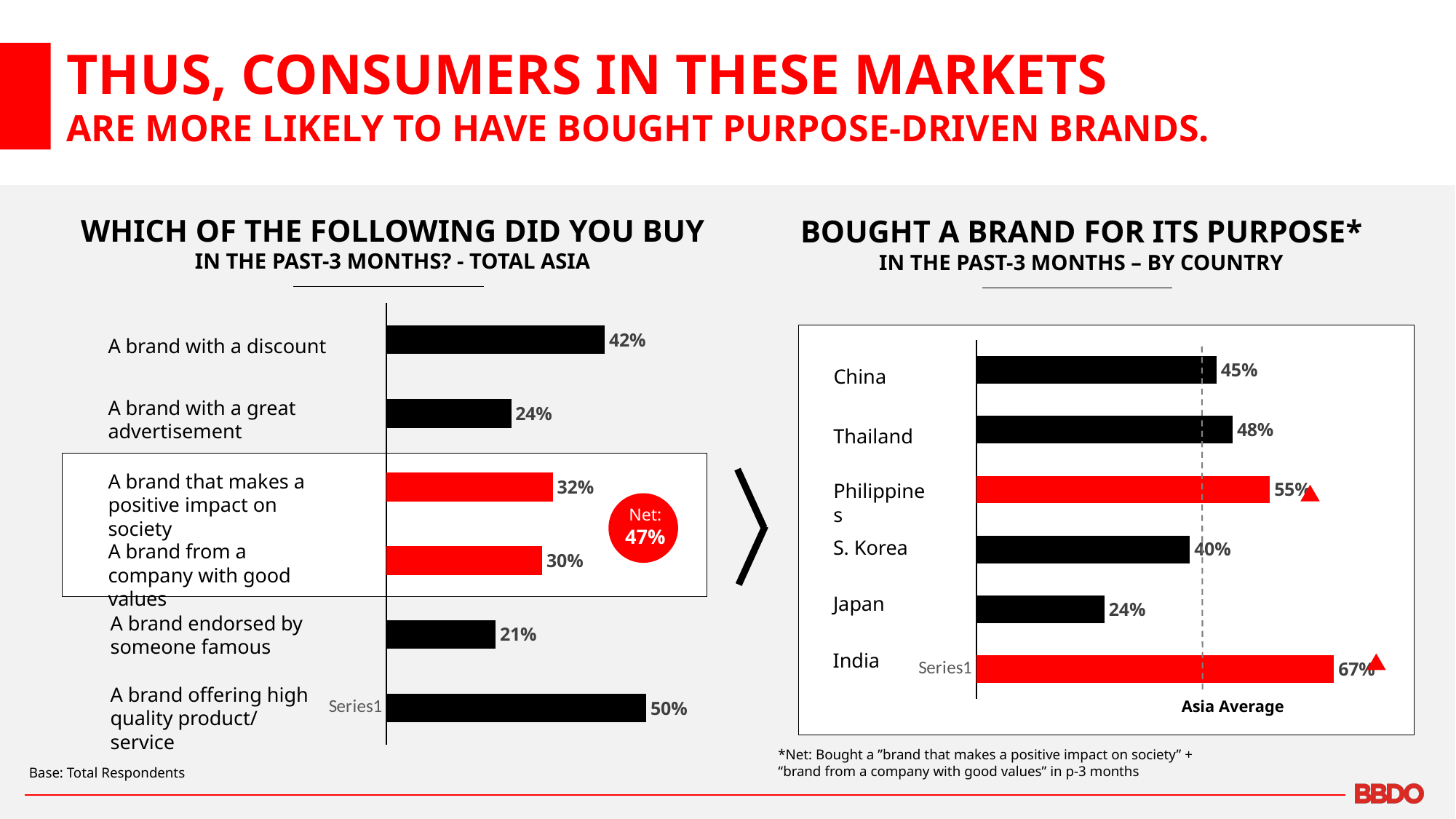
In the right chart 'Bought a brand for its purpose in the past-3 months – by country', which is larger, the value for China or the value for S. Korea? China What type of chart is the right chart 'Bought a brand for its purpose in the past-3 months – by country'? Bar chart In the left chart 'Which of the following did you buy in the past-3 months? - Total Asia', what is the value for 'A brand with a discount'? 42% In the right chart 'Bought a brand for its purpose in the past-3 months – by country', which country has the highest value? India In the left chart 'Which of the following did you buy in the past-3 months? - Total Asia', which category has the highest value? A brand offering high quality product/service In the right chart 'Bought a brand for its purpose in the past-3 months – by country', which country has the lowest value? Japan In the left chart 'Which of the following did you buy in the past-3 months? - Total Asia', how many categories are plotted? 6 In the left chart 'Which of the following did you buy in the past-3 months? - Total Asia', what is the difference between 'A brand with a discount' and 'A brand with a great advertisement'? 18% In the right chart 'Bought a brand for its purpose in the past-3 months – by country', what is the value for Thailand? 48% In the right chart 'Bought a brand for its purpose in the past-3 months – by country', what is the difference between India and Japan? 43% In the left chart 'Which of the following did you buy in the past-3 months? - Total Asia', what is the Net value shown in the red circle? 47% In the left chart 'Which of the following did you buy in the past-3 months? - Total Asia', which category has the lowest value? A brand endorsed by someone famous